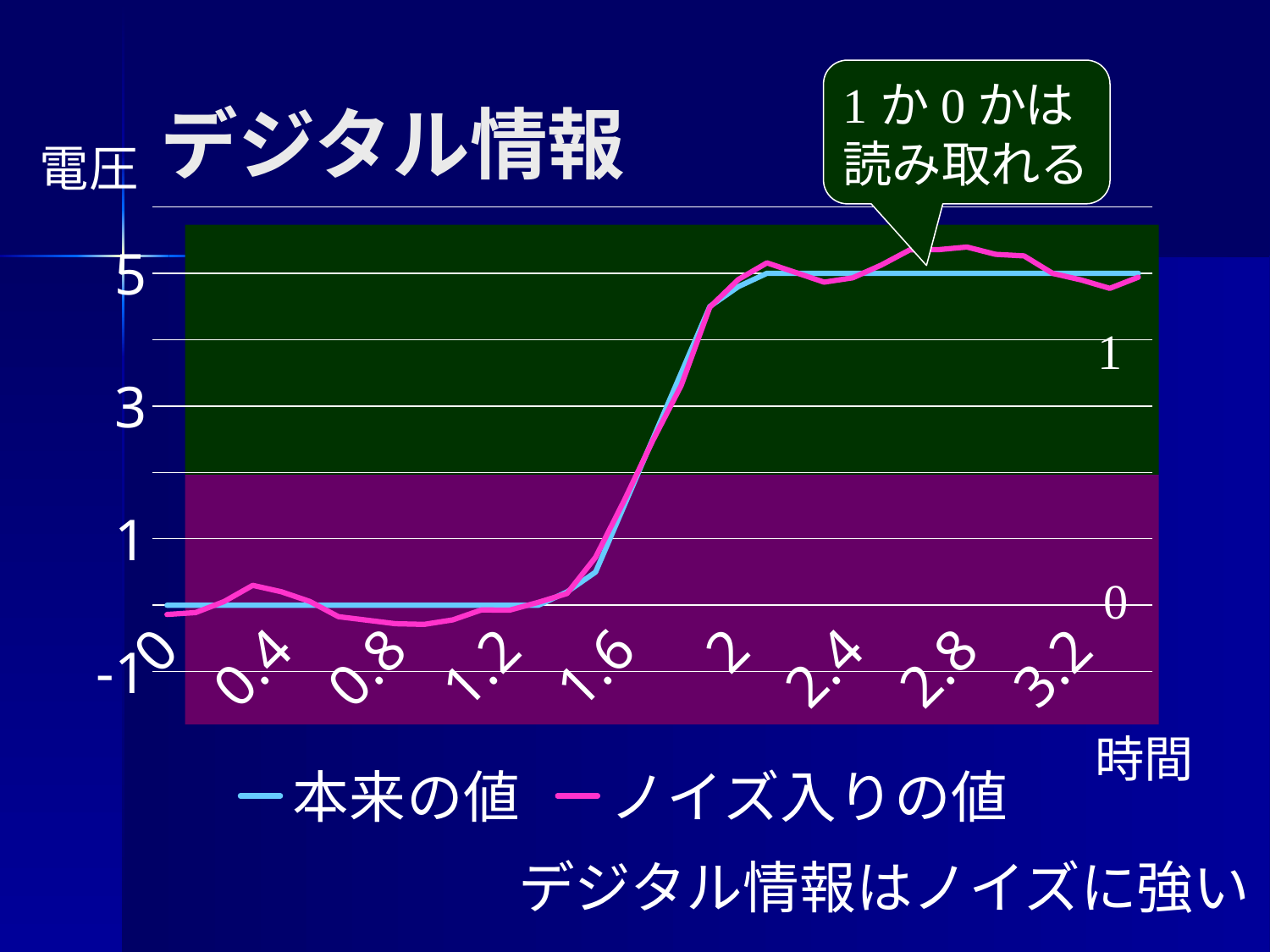
At time 0.4, which series has the larger value, 本来の値 or ノイズ入りの値? ノイズ入りの値 What is the value of 本来の値 at time 2.4? 5 How many series does the legend list? 2 What kind of chart is shown on the slide? line chart At time 0.8, which series has the larger value, 本来の値 or ノイズ入りの値? 本来の値 How many tick labels are shown on the x axis? 9 What is the title of the chart? デジタル情報 What is the value of 本来の値 at time 2.8? 5 Is the value of ノイズ入りの値 at time 2.4 greater or less than 3? greater Is the value of 本来の値 at time 0.8 greater or less than 1? less Does the 本来の値 line rise or fall between time 1.6 and time 2? rise What are the two series named in the legend? 本来の値, ノイズ入りの値